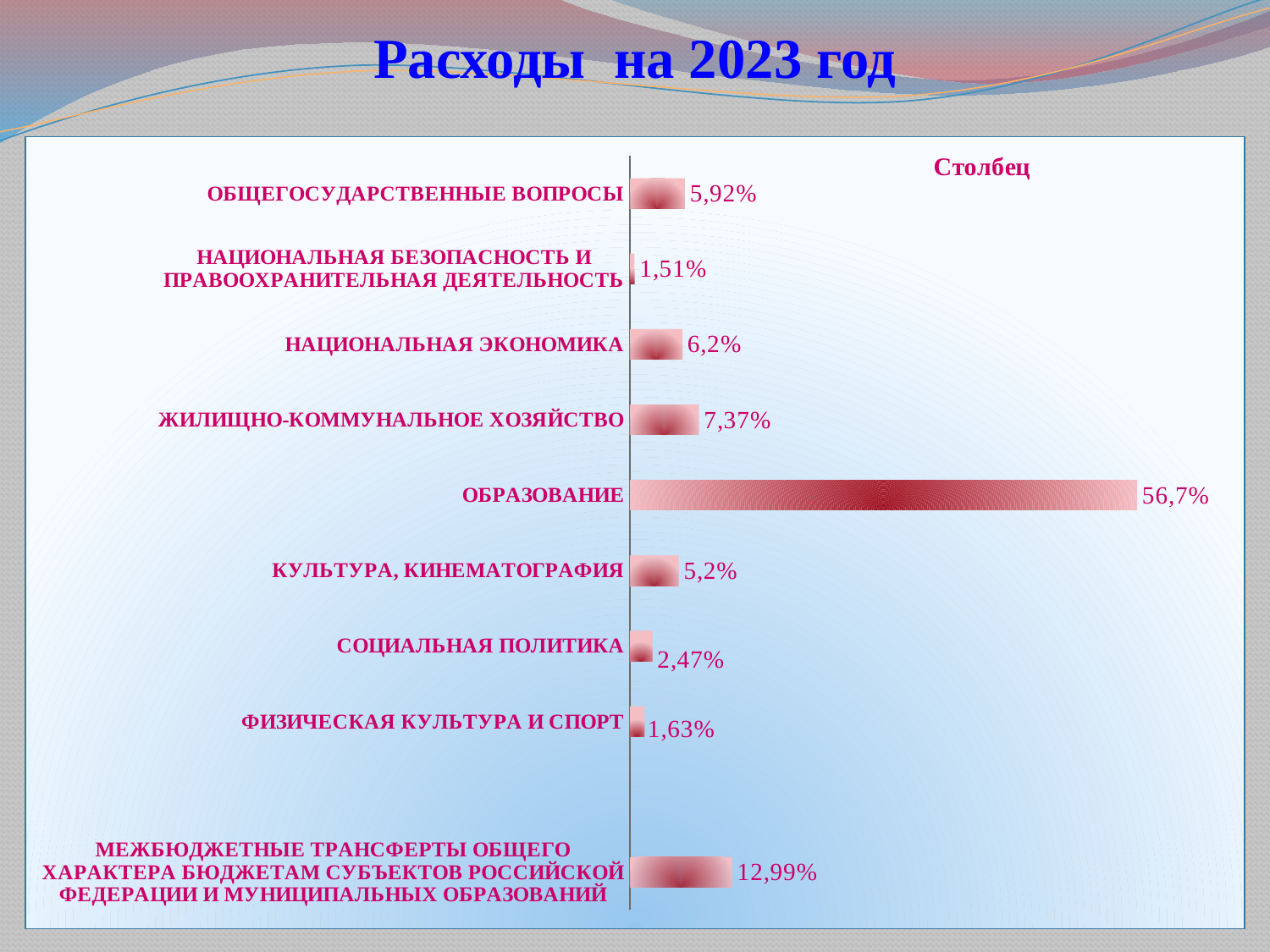
What is the value for СОЦИАЛЬНАЯ ПОЛИТИКА? 2,47% What is the value for МЕЖБЮДЖЕТНЫЕ ТРАНСФЕРТЫ ОБЩЕГО ХАРАКТЕРА БЮДЖЕТАМ СУБЪЕКТОВ РОССИЙСКОЙ ФЕДЕРАЦИИ И МУНИЦИПАЛЬНЫХ ОБРАЗОВАНИЙ? 12,99% What is the value for ЖИЛИЩНО-КОММУНАЛЬНОЕ ХОЗЯЙСТВО? 7,37% What kind of chart is shown on the slide? Bar chart Which is larger, the value for ОБЩЕГОСУДАРСТВЕННЫЕ ВОПРОСЫ or the value for КУЛЬТУРА, КИНЕМАТОГРАФИЯ? ОБЩЕГОСУДАРСТВЕННЫЕ ВОПРОСЫ How many categories are shown in the chart? 9 Which category has the highest value? ОБРАЗОВАНИЕ Which category has the lowest value? НАЦИОНАЛЬНАЯ БЕЗОПАСНОСТЬ И ПРАВООХРАНИТЕЛЬНАЯ ДЕЯТЕЛЬНОСТЬ What is the difference between the values for ОБРАЗОВАНИЕ and МЕЖБЮДЖЕТНЫЕ ТРАНСФЕРТЫ ОБЩЕГО ХАРАКТЕРА БЮДЖЕТАМ СУБЪЕКТОВ РОССИЙСКОЙ ФЕДЕРАЦИИ И МУНИЦИПАЛЬНЫХ ОБРАЗОВАНИЙ? 43,71% What is the difference between the values for ЖИЛИЩНО-КОММУНАЛЬНОЕ ХОЗЯЙСТВО and НАЦИОНАЛЬНАЯ ЭКОНОМИКА? 1,17% What is the value for ОБРАЗОВАНИЕ? 56,7%